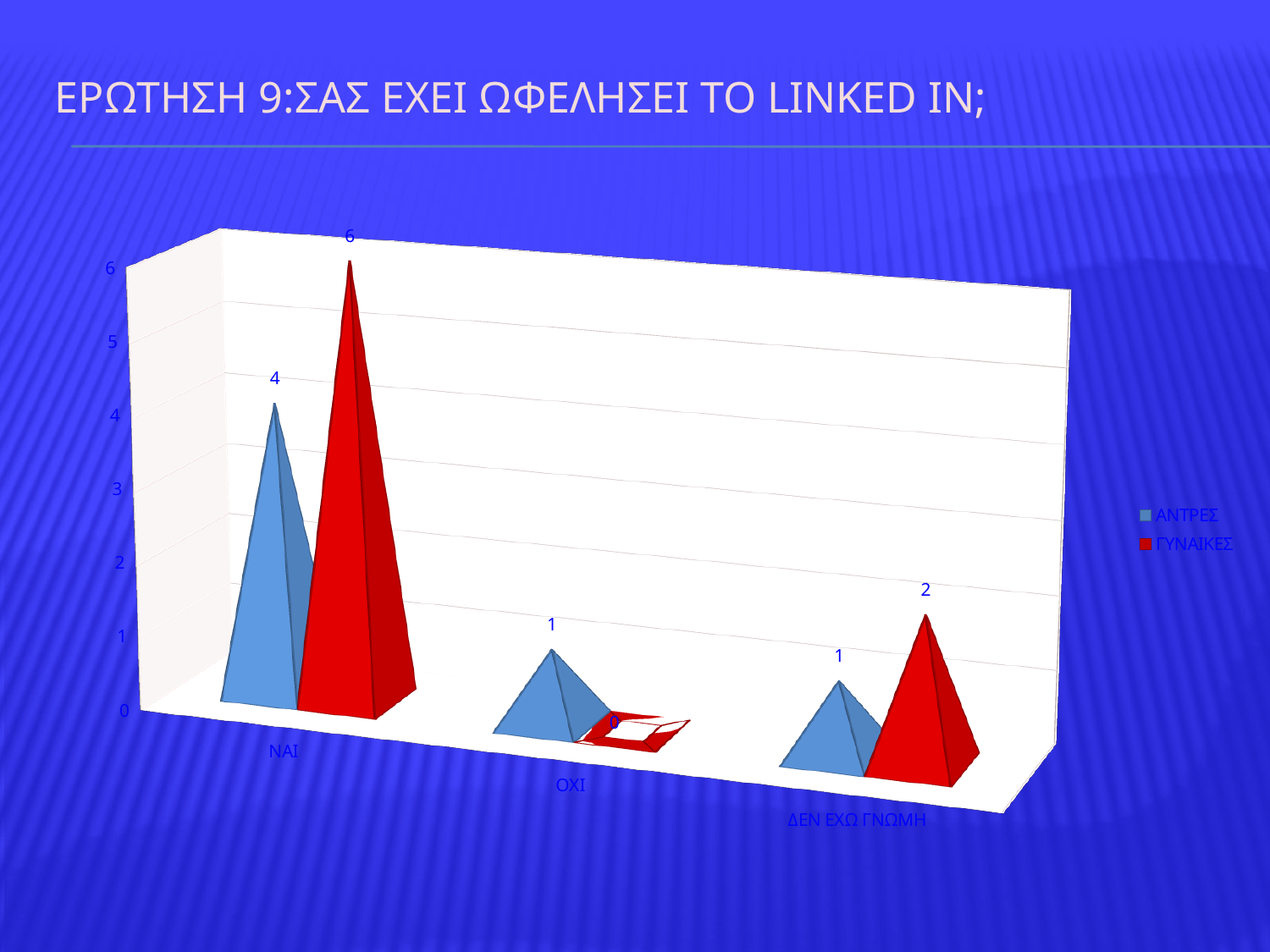
How many categories are shown on the x axis? 3 Which colour represents the ΓΥΝΑΙΚΕΣ series? Red What is the value for ΑΝΤΡΕΣ in the ΝΑΙ category? 4 What is the difference between the ΓΥΝΑΙΚΕΣ and ΑΝΤΡΕΣ values in the ΝΑΙ category? 2 What is the value for ΓΥΝΑΙΚΕΣ in the ΟΧΙ category? 0 What kind of chart is shown on the slide? Bar chart In the ΔΕΝ ΕΧΩ ΓΝΩΜΗ category, which series has the larger value, ΑΝΤΡΕΣ or ΓΥΝΑΙΚΕΣ? ΓΥΝΑΙΚΕΣ Which category has the highest value for ΓΥΝΑΙΚΕΣ? ΝΑΙ Which category has the lowest value for ΓΥΝΑΙΚΕΣ? ΟΧΙ What is the value for ΓΥΝΑΙΚΕΣ in the ΔΕΝ ΕΧΩ ΓΝΩΜΗ category? 2 How many series does the legend list? 2 What is the value for ΓΥΝΑΙΚΕΣ in the ΝΑΙ category? 6